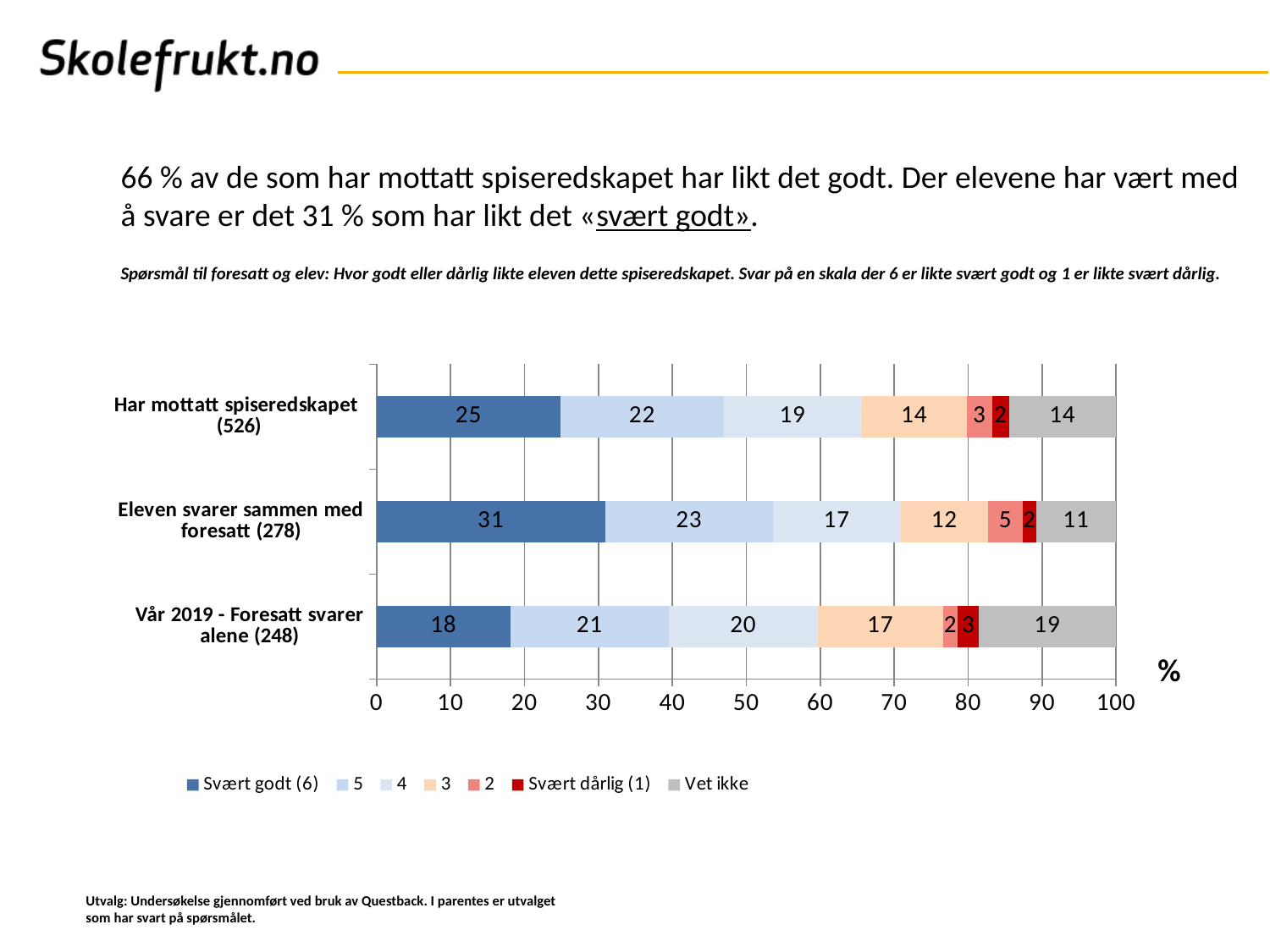
How many series does the legend list? 7 What is the total of the stacked bar for 'Vår 2019 - Foresatt svarer alene (248)'? 100 What kind of chart is shown on the slide? Stacked bar chart Which is larger: the 'Vet ikke' value for 'Har mottatt spiseredskapet (526)' or for 'Vår 2019 - Foresatt svarer alene (248)'? Vår 2019 - Foresatt svarer alene (248) What is the value for series '3' in the 'Har mottatt spiseredskapet (526)' bar? 14 What is the first series listed in the legend? Svært godt (6) How many categories (bars) does the chart show? 3 What is the 'Vet ikke' value for 'Vår 2019 - Foresatt svarer alene (248)'? 19 Which category has the lowest 'Svært godt (6)' value? Vår 2019 - Foresatt svarer alene (248) What is the 'Svært godt (6)' value for 'Eleven svarer sammen med foresatt (278)'? 31 What is the difference between the 'Svært godt (6)' values for 'Eleven svarer sammen med foresatt (278)' and 'Har mottatt spiseredskapet (526)'? 6 Which category has the highest 'Svært godt (6)' value? Eleven svarer sammen med foresatt (278)